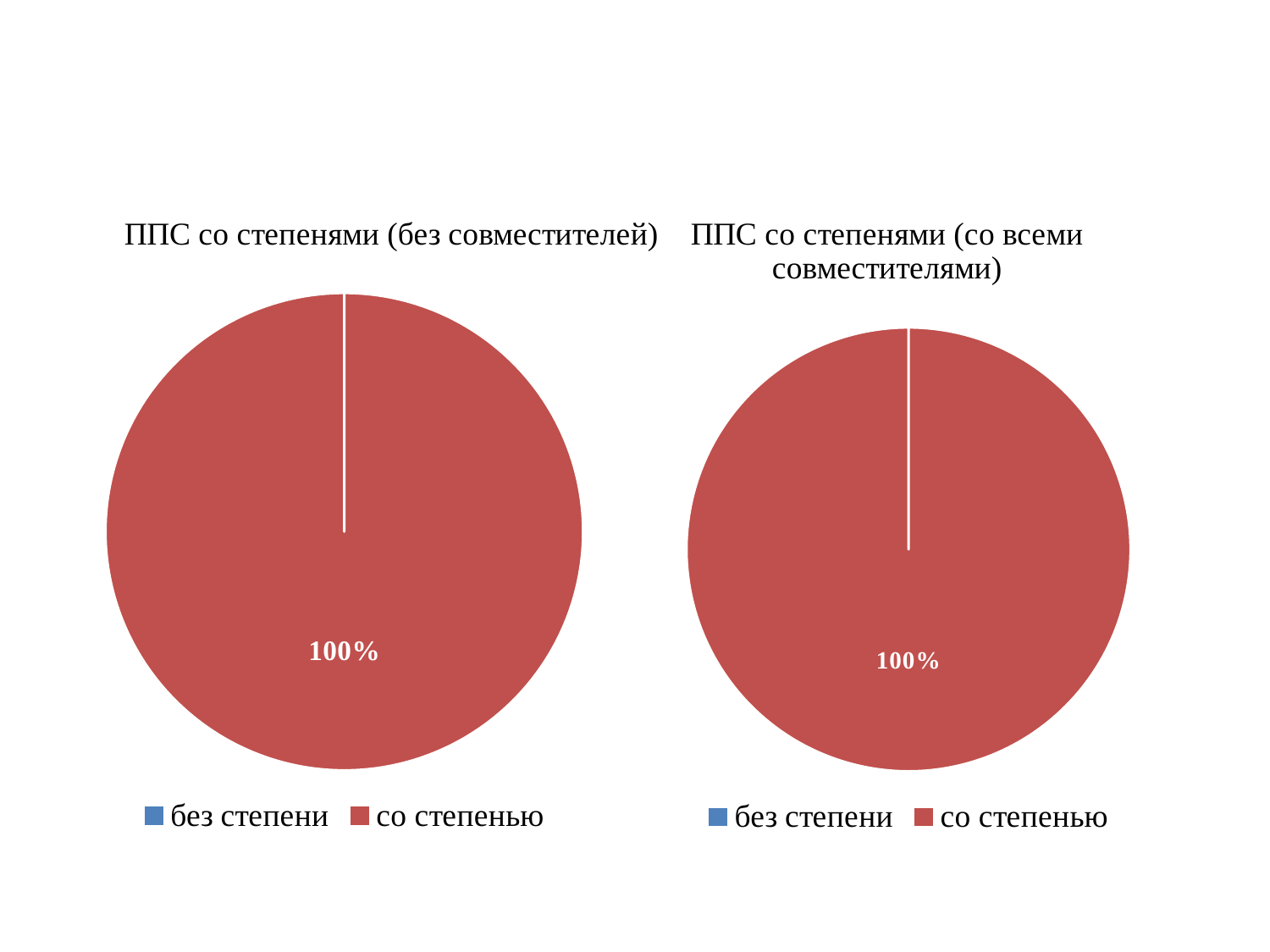
In the left chart "ППС со степенями (без совместителей)", what share of the pie is labelled for "со степенью"? 100% In the right chart "ППС со степенями (со всеми совместителями)", which category is larger, "без степени" or "со степенью"? со степенью How many entries does the legend of the right chart "ППС со степенями (со всеми совместителями)" list? 2 What is the title of the chart on the left of the slide? ППС со степенями (без совместителей) In the right chart "ППС со степенями (со всеми совместителями)", what share of the pie is labelled for "со степенью"? 100% In the left chart "ППС со степенями (без совместителей)", which category has the largest slice? со степенью How many entries does the legend of the left chart "ППС со степенями (без совместителей)" list? 2 In the right chart "ППС со степенями (со всеми совместителями)", what colour is the slice for "со степенью"? red What kind of chart is the right chart titled "ППС со степенями (со всеми совместителями)"? pie chart What kind of chart is the left chart titled "ППС со степенями (без совместителей)"? pie chart In the left chart "ППС со степенями (без совместителей)", which category is larger, "без степени" or "со степенью"? со степенью In the right chart "ППС со степенями (со всеми совместителями)", which category has the largest slice? со степенью